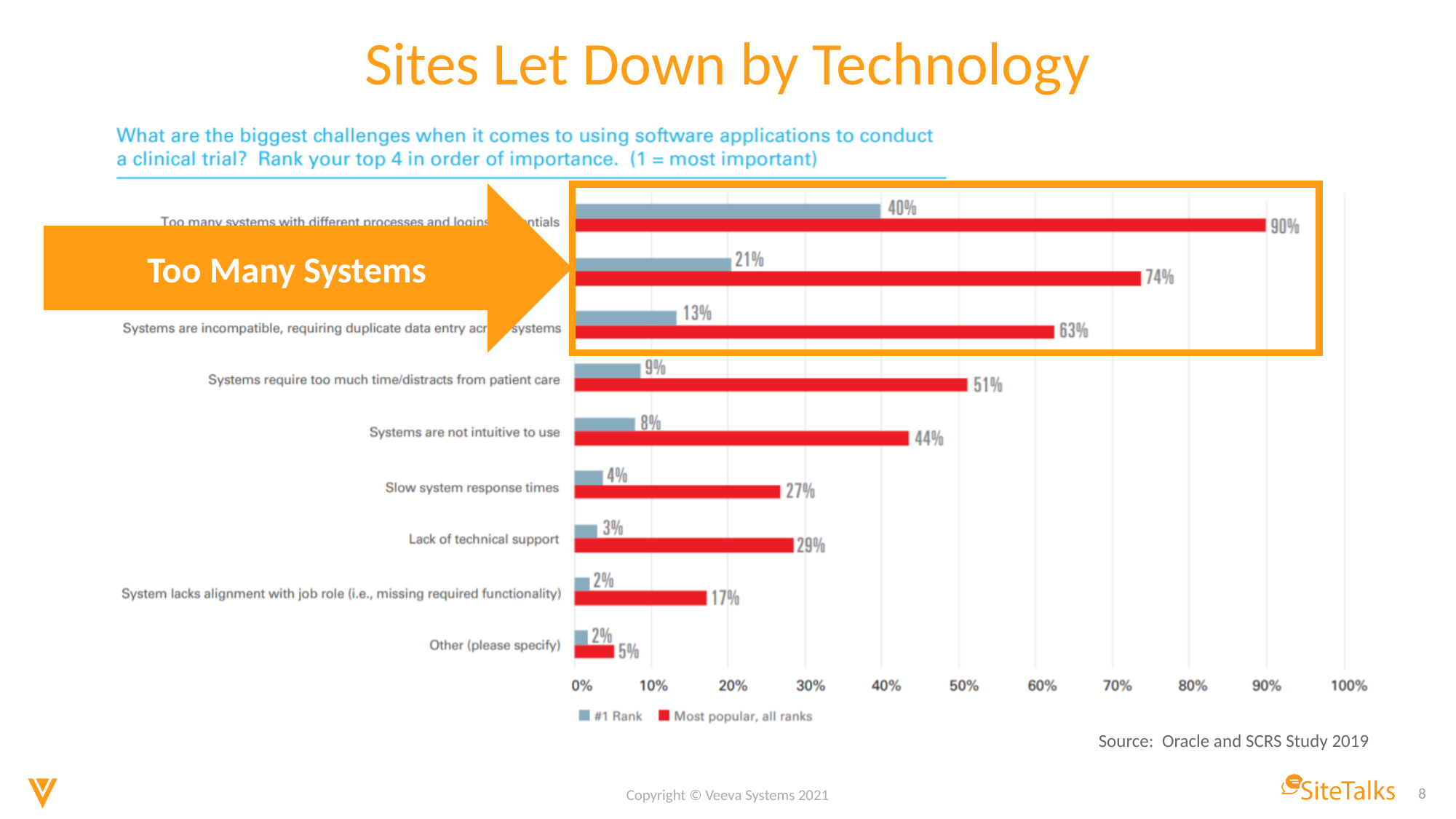
Which category has the highest 'Most popular, all ranks' value? Too many systems with different processes and logins/credentials Is the 'Most popular, all ranks' value for 'Systems are incompatible, requiring duplicate data entry across systems' greater or less than 50%? greater What is the difference between the 'Most popular, all ranks' and '#1 Rank' values for 'Slow system response times'? 23% What is the 'Most popular, all ranks' value for 'Lack of technical support'? 29% Which category has the lowest 'Most popular, all ranks' value? Other (please specify) How many categories are shown in the chart? 9 Which has a larger 'Most popular, all ranks' value: 'Slow system response times' or 'Lack of technical support'? Lack of technical support What is the '#1 Rank' value for 'Systems require too much time/distracts from patient care'? 9% What is the 'Most popular, all ranks' value for 'Systems are not intuitive to use'? 44% What colour are the 'Most popular, all ranks' bars? Red What kind of chart is shown on the slide? Bar chart How many series does the legend list? 2